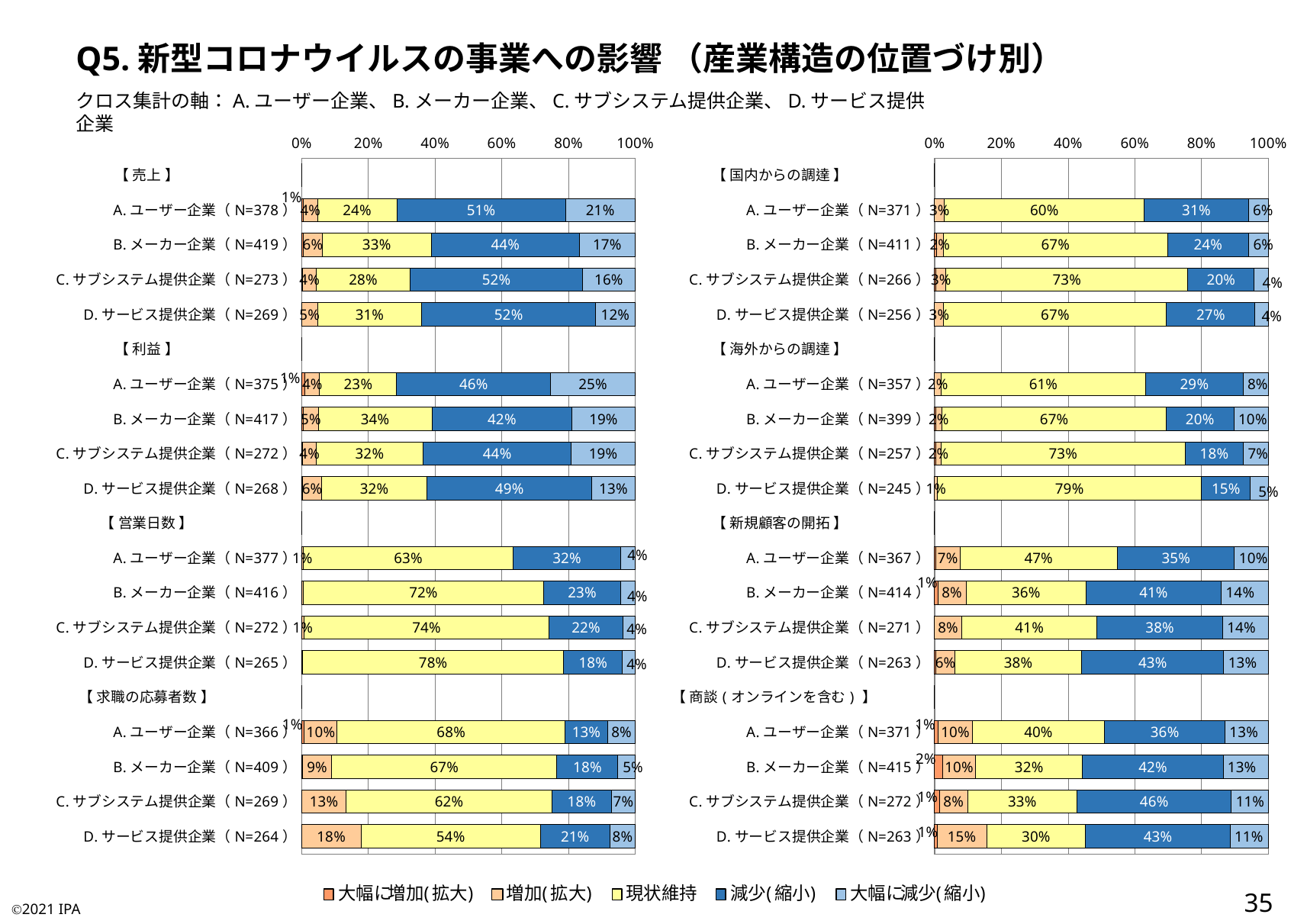
In the right chart, under 【海外からの調達】, what is the 現状維持 value for D. サービス提供企業 (N=245)? 79% In the right chart, under 【新規顧客の開拓】, what is the 減少(縮小) value for B. メーカー企業 (N=414)? 41% How many question sections (bracketed headings) does the left chart contain? 4 In the left chart, under 【売上】, which has the larger 減少(縮小) value: B. メーカー企業 or C. サブシステム提供企業? C. サブシステム提供企業 What kind of chart is used on this slide? Stacked bar chart How many series does the legend at the bottom of the slide list? 5 In the left chart, under 【利益】, what is the 大幅に減少(縮小) value for A. ユーザー企業 (N=375)? 25% In the right chart, under 【国内からの調達】, what is the difference between the 現状維持 values for C. サブシステム提供企業 (73%) and A. ユーザー企業 (60%)? 13 percentage points In the left chart, under 【求職の応募者数】, what is the 増加(拡大) value for D. サービス提供企業 (N=264)? 18% In the left chart, under 【営業日数】, which company type has the highest 現状維持 value? D. サービス提供企業 What colour represents 現状維持 in the legend? Yellow In the left chart, under 【売上】, what is the 減少(縮小) value for A. ユーザー企業 (N=378)? 51%